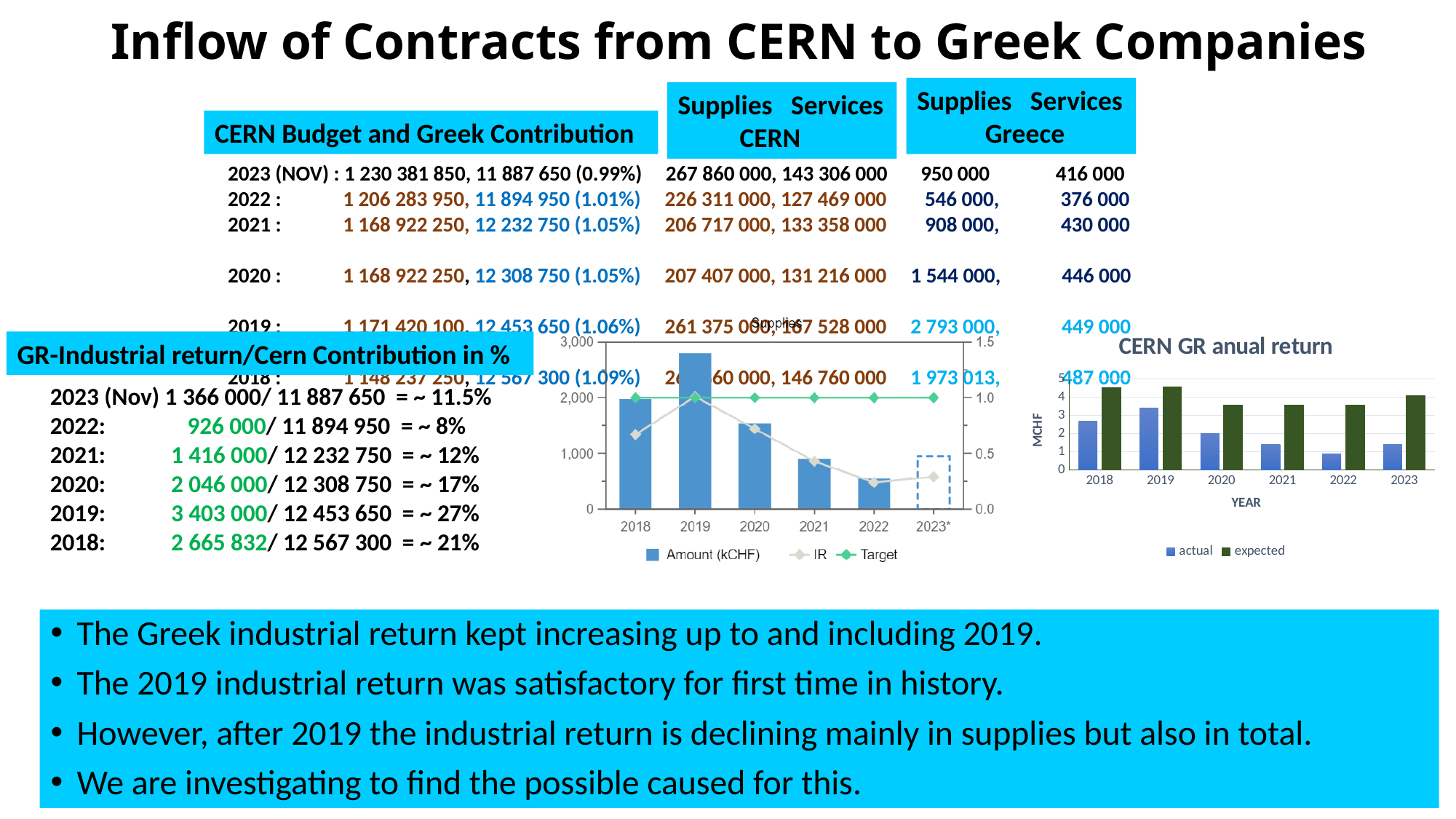
In the 'CERN GR anual return' chart, which year has the highest 'actual' value? 2019 In the middle chart with the 'Amount (kCHF)' bars, which year has the tallest bar? 2019 In the middle chart with the 'Amount (kCHF)' bars, do the bar values rise or fall from 2019 to 2022? fall In the 'CERN GR anual return' chart, which year has the lowest 'actual' value? 2022 In the 'CERN GR anual return' chart, what is the label of the y axis? MCHF In the 'CERN GR anual return' chart, is the 'actual' value for 2019 greater or less than 3? greater How many series does the legend of the 'CERN GR anual return' chart list? 2 What kind of chart is the 'CERN GR anual return' chart? bar chart In the middle chart with the 'Amount (kCHF)' bars, is the bar for 2019 greater or less than 2,000? greater In the 'CERN GR anual return' chart, which is larger for 2020: the 'actual' or the 'expected' value? expected How many years are shown on the x axis of the 'CERN GR anual return' chart? 6